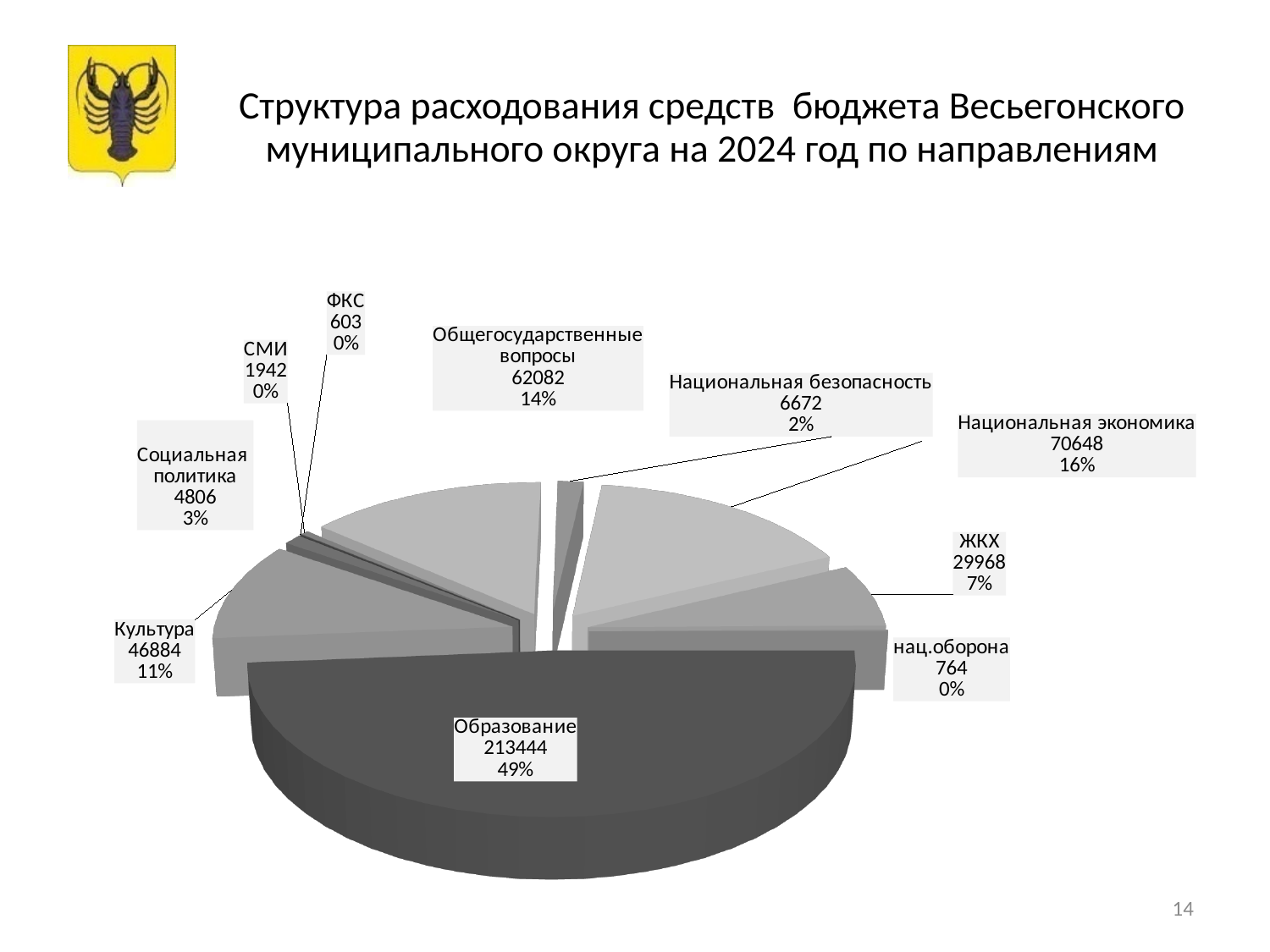
What is the value for Образование? 213444 Which is larger, the value for Культура or the value for ЖКХ? Культура What is the value for Социальная политика? 4806 How many categories are shown in the pie chart? 10 What share of the pie does Общегосударственные вопросы take? 14% Which category has the lowest value? ФКС What is the value for ЖКХ? 29968 Which category has the highest value? Образование What share of the pie does Образование take? 49% What is the difference between the values for Национальная экономика and Общегосударственные вопросы? 8566 What kind of chart is shown on the slide? pie chart What is the value for Национальная экономика? 70648